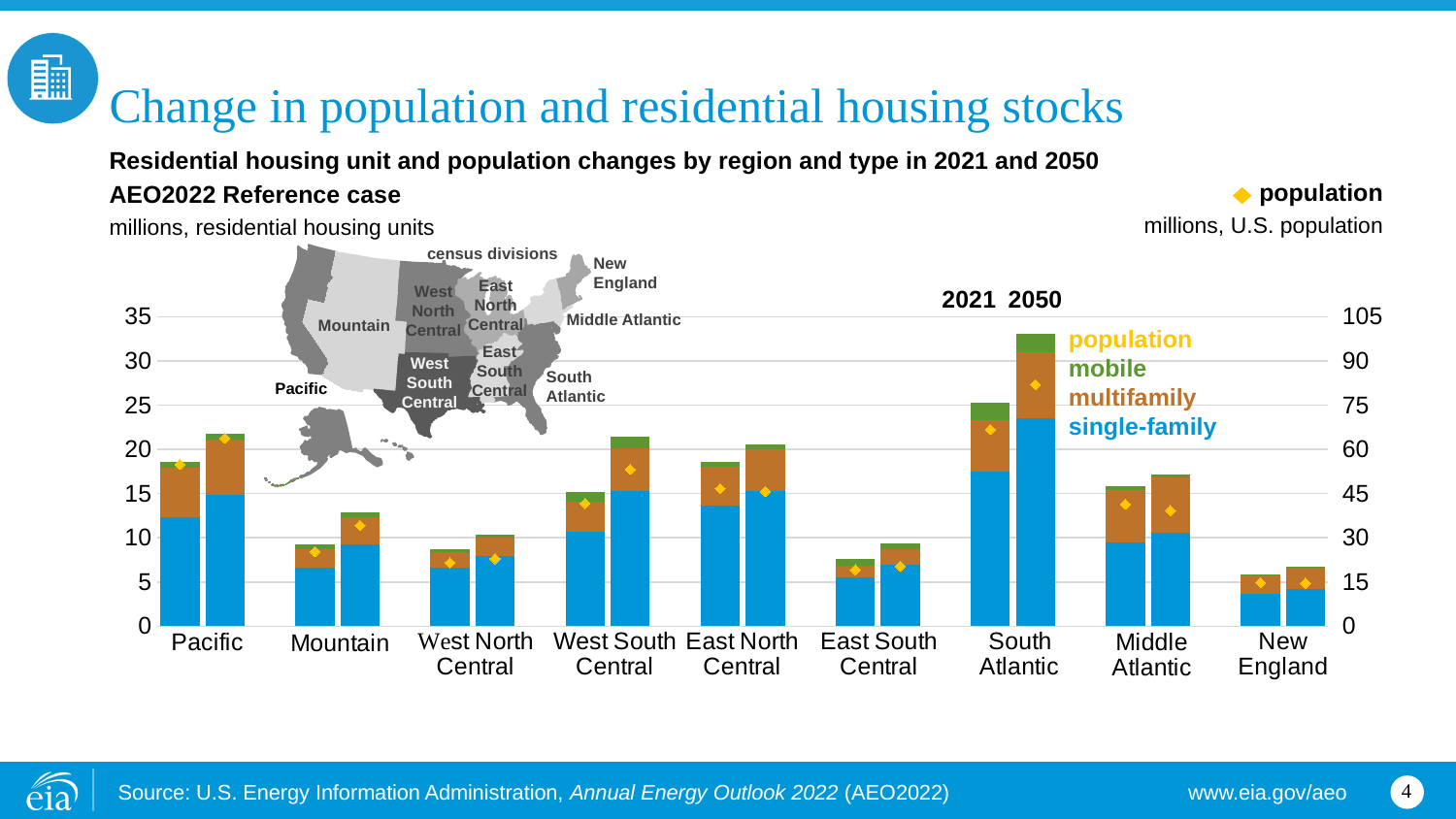
Is the total residential housing units value for New England in 2021 greater or less than 10? less Which is larger in 2021: the total bar for East North Central or the total bar for Mountain? East North Central Is the total residential housing units value for South Atlantic in 2050 greater or less than 30? greater What kind of chart is shown on the slide? stacked bar chart How many census regions are shown along the x axis of the chart? 9 Which region has the shortest bars in the chart? New England How many series does the chart's legend list? 4 Is the total residential housing units value for Pacific in 2021 greater or less than 15? greater What unit is shown on the right-hand axis of the chart? millions, U.S. population Which series in the legend is shown in blue? single-family Which is larger in 2050: the total bar for South Atlantic or the total bar for Pacific? South Atlantic Which region has the tallest bar for 2050? South Atlantic